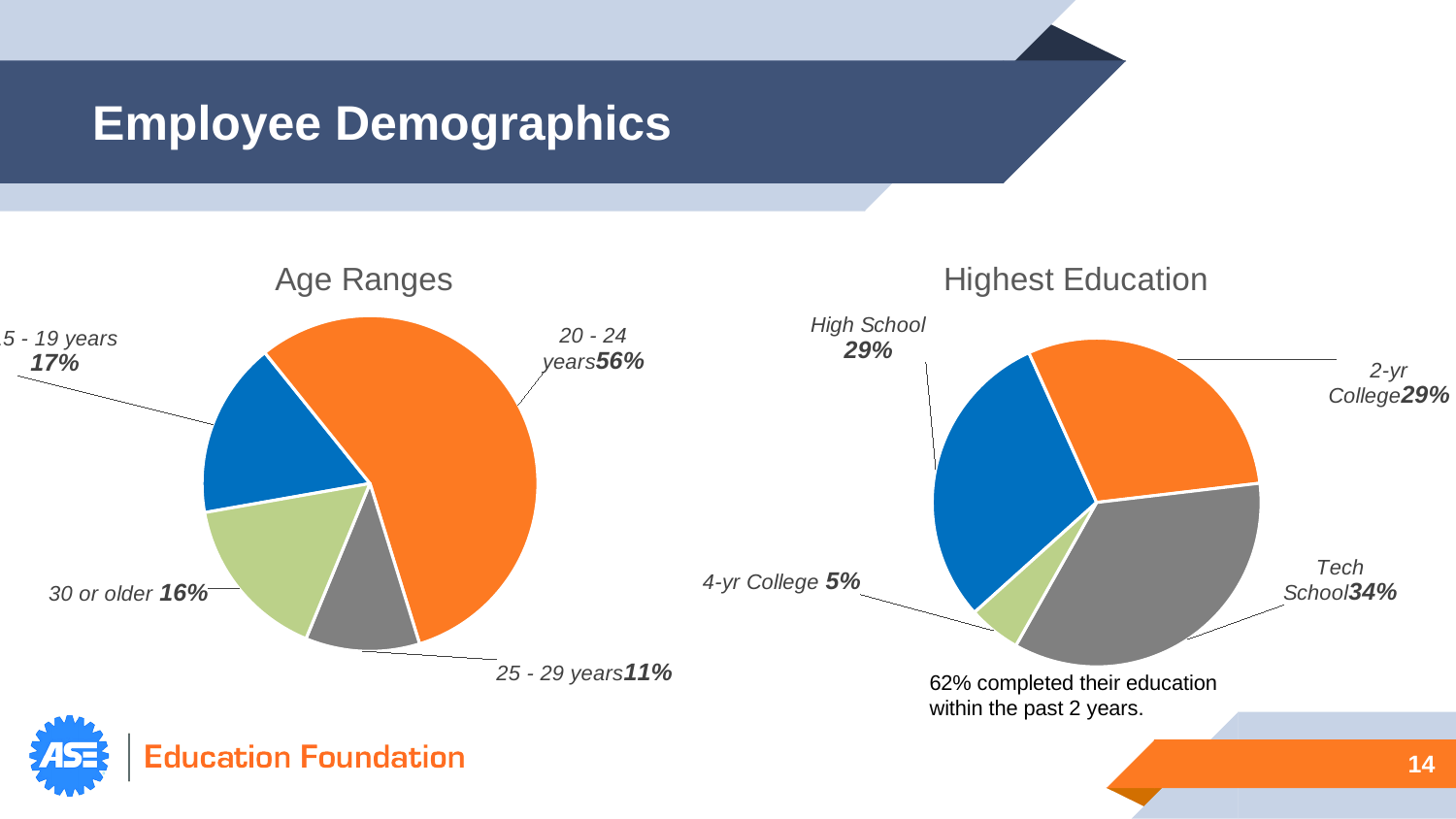
In the Highest Education chart, what percentage of employees have Tech School as their highest education? 34% In the Highest Education chart, which is larger: Tech School or High School? Tech School In the Age Ranges chart, how many slices does the pie have? 4 In the Age Ranges chart, which age range has the smallest share? 25 - 29 years In the Age Ranges chart, what is the difference between the 30 or older share and the 25 - 29 years share? 5% In the Highest Education chart, what share is shown for 4-yr College? 5% What type of chart is used for Highest Education? Pie chart In the Age Ranges chart, which age range has the largest share? 20 - 24 years In the Age Ranges chart, what percentage of employees are 20 - 24 years old? 56% In the Age Ranges chart, what share is shown for 30 or older? 16% In the Highest Education chart, which category has the largest share? Tech School In the Highest Education chart, what is the difference between the Tech School share and the 4-yr College share? 29%